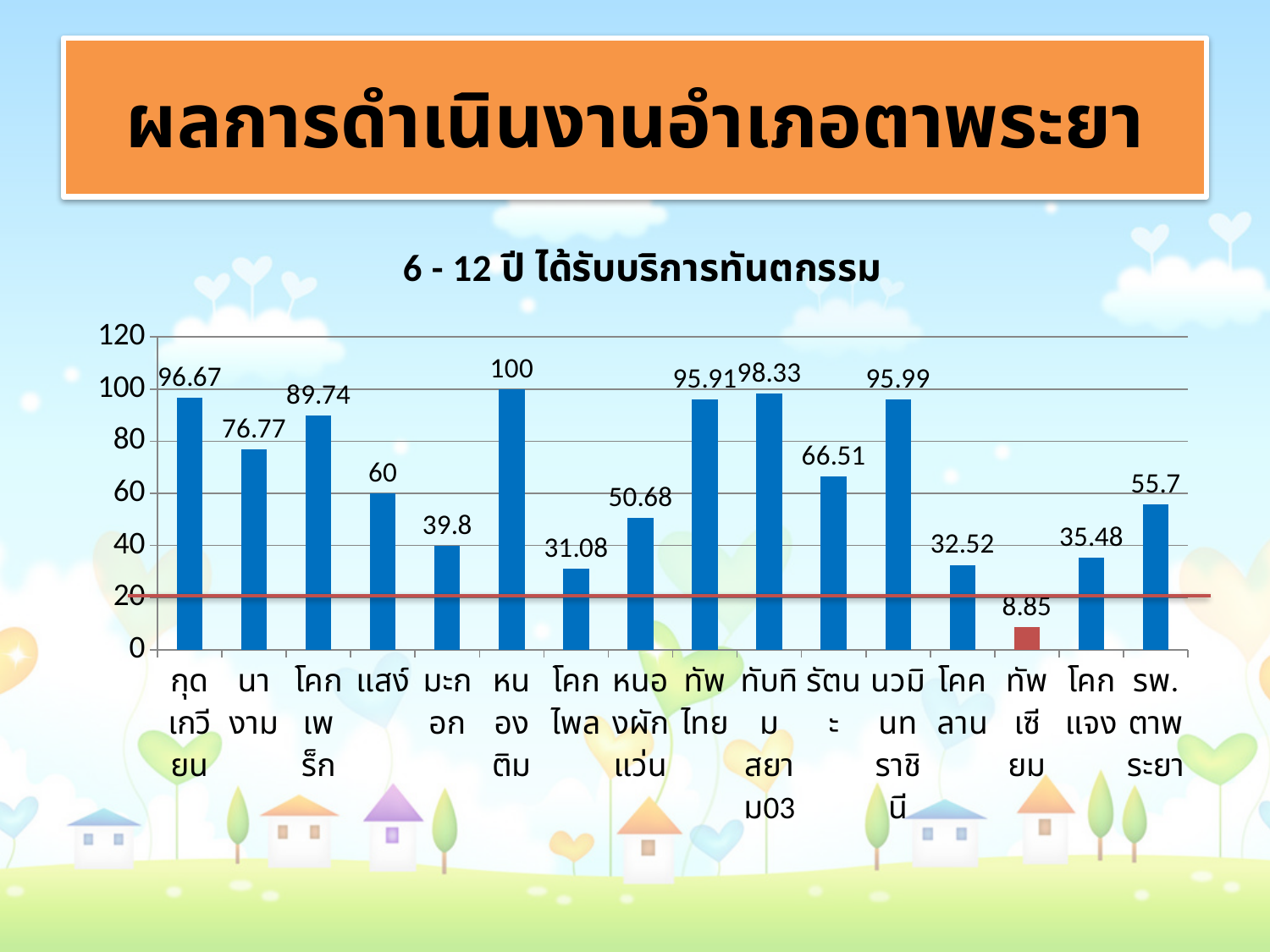
Which category has the highest value? หนองติม What is the value for หนองติม? 100 What is the value for รพ.ตาพระยา? 55.7 What is the value for ทัพเซียม? 8.85 Which category has the lowest value? ทัพเซียม What kind of chart is shown on the slide? bar chart Is the value for มะกอก greater or less than 40? less How many categories are shown on the x axis? 16 What is the title of the chart? 6 - 12 ปี ได้รับบริการทันตกรรม What is the difference between the values for กุดเกวียน and นางาม? 19.9 Which is larger, the value for โคกไพล or the value for โคคลาน? โคคลาน At what value on the y axis is the red horizontal line drawn? 20